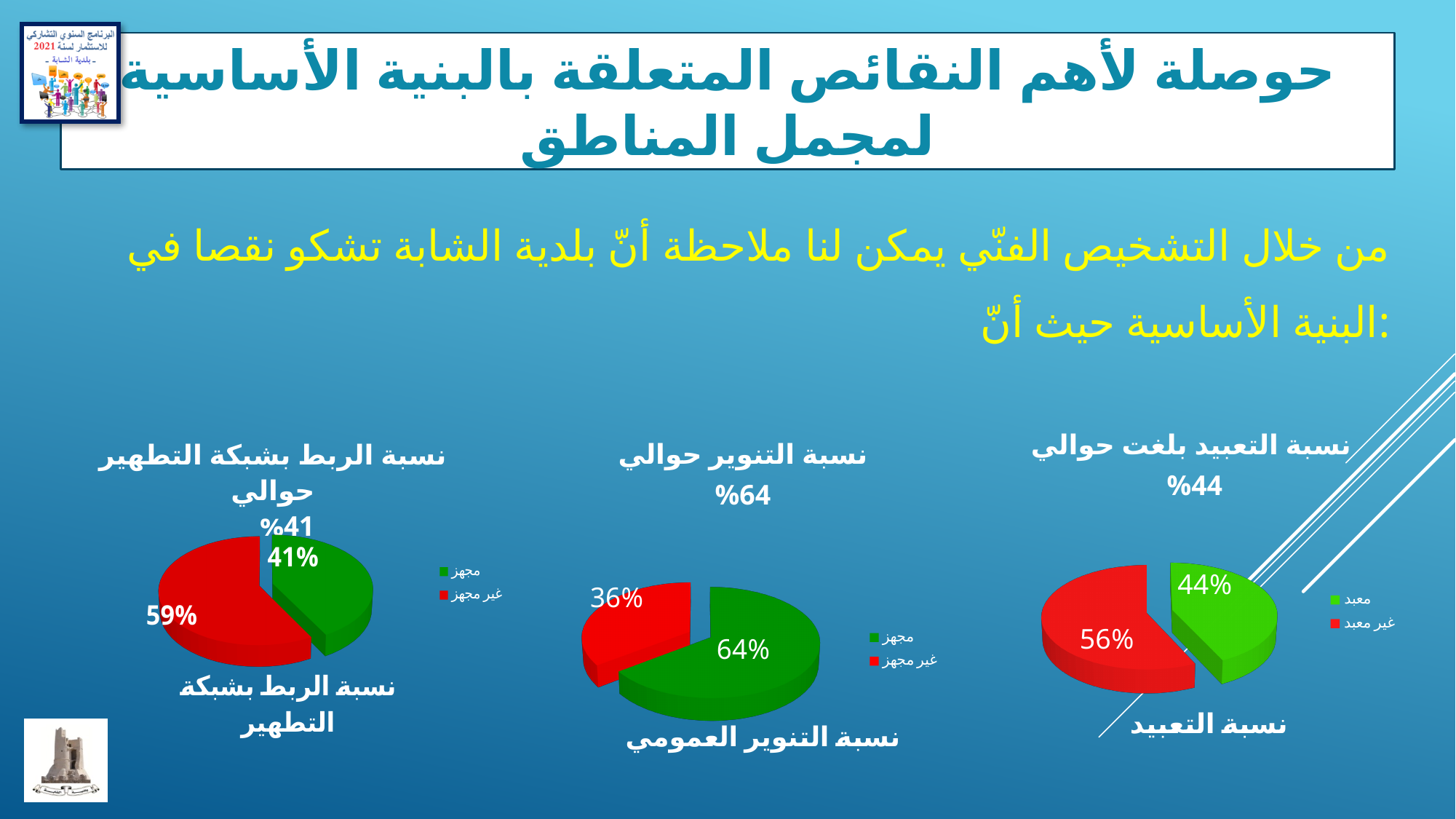
What type of charts are shown on the slide? Pie charts In the left-hand chart titled نسبة الربط بشبكة التطهير, what is the difference between the غير مجهز slice and the مجهز slice? 18% In the left-hand chart titled نسبة الربط بشبكة التطهير, what is the value of the green slice (مجهز)? 41% How many entries does the legend of the right-hand chart titled نسبة التعبيد list? 2 In the middle chart titled نسبة التنوير العمومي, what is the value of the red slice (غير مجهز)? 36% In the right-hand chart titled نسبة التعبيد, what is the difference between the غير معبد slice and the معبد slice? 12% In the left-hand chart titled نسبة الربط بشبكة التطهير, what is the value of the red slice (غير مجهز)? 59% In the middle chart titled نسبة التنوير العمومي, what is the value of the green slice (مجهز)? 64% In the right-hand chart titled نسبة التعبيد, what is the value of the green slice (معبد)? 44% In the middle chart titled نسبة التنوير العمومي, which slice is larger, مجهز or غير مجهز? مجهز How many charts are on the slide? 3 In the right-hand chart titled نسبة التعبيد, what is the value of the red slice (غير معبد)? 56%